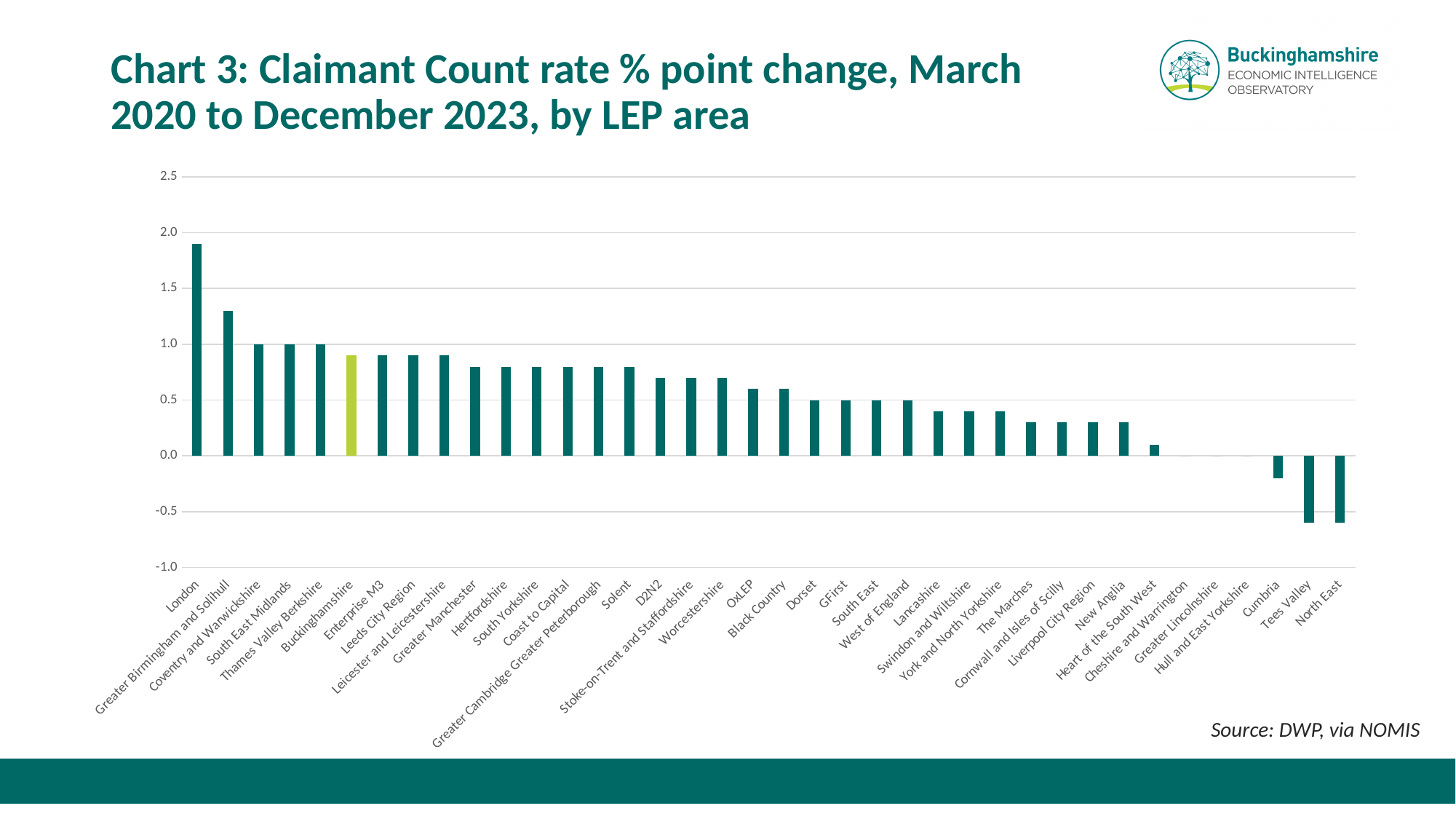
Is the value for Cumbria greater or less than 0.0? less What is the claimant count rate % point change for Thames Valley Berkshire? 1.0 Which LEP area has the highest claimant count rate % point change? London Which LEP area's bar is highlighted in a different (light green) colour? Buckinghamshire Which has the larger value, London or Greater Birmingham and Solihull? London What kind of chart is shown on the slide? Bar chart Is the value for Heart of the South West greater or less than 0.5? less How many LEP areas are listed on the x axis? 38 Is the value for Buckinghamshire greater or less than 1.0? less What is the claimant count rate % point change for Dorset? 0.5 Do the values rise or fall moving from left to right along the x axis? Fall